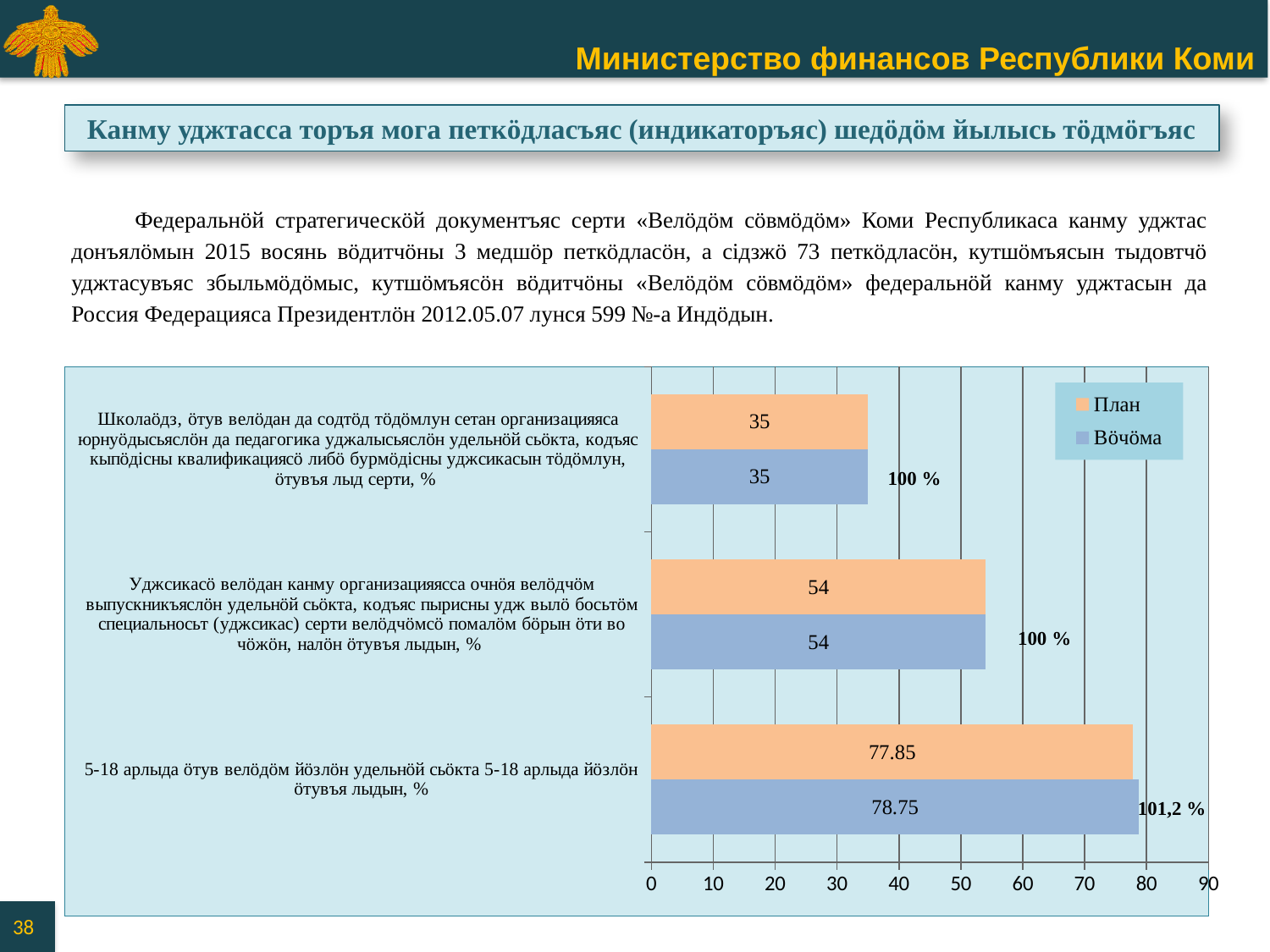
What is the План value for the category beginning "Школаöдз, öтув велöдан да содтöд тöдöмлун сетан организацияяса"? 35 What percentage label is shown next to the bars for the category beginning "5-18 арлыда"? 101,2 % How many categories are plotted on the chart? 3 For the category beginning "5-18 арлыда", what is the difference between the Вöчöма value and the План value? 0.9 What kind of chart is shown on the slide? bar chart What is the Вöчöма value for the category beginning "5-18 арлыда öтув велöдöм йöзлöн удельнöй сьöкта"? 78.75 What is the План value for the category beginning "5-18 арлыда öтув велöдöм йöзлöн удельнöй сьöкта"? 77.85 Which category has the highest Вöчöма value? 5-18 арлыда öтув велöдöм йöзлöн удельнöй сьöкта 5-18 арлыда йöзлöн öтувъя лыдын, % How many series does the chart legend list? 2 What are the two series named in the chart legend? План and Вöчöма What is the Вöчöма value for the category beginning "Уджсикасö велöдан канму организацияясса очнöя велöдчöм выпускникъяслöн удельнöй сьöкта"? 54